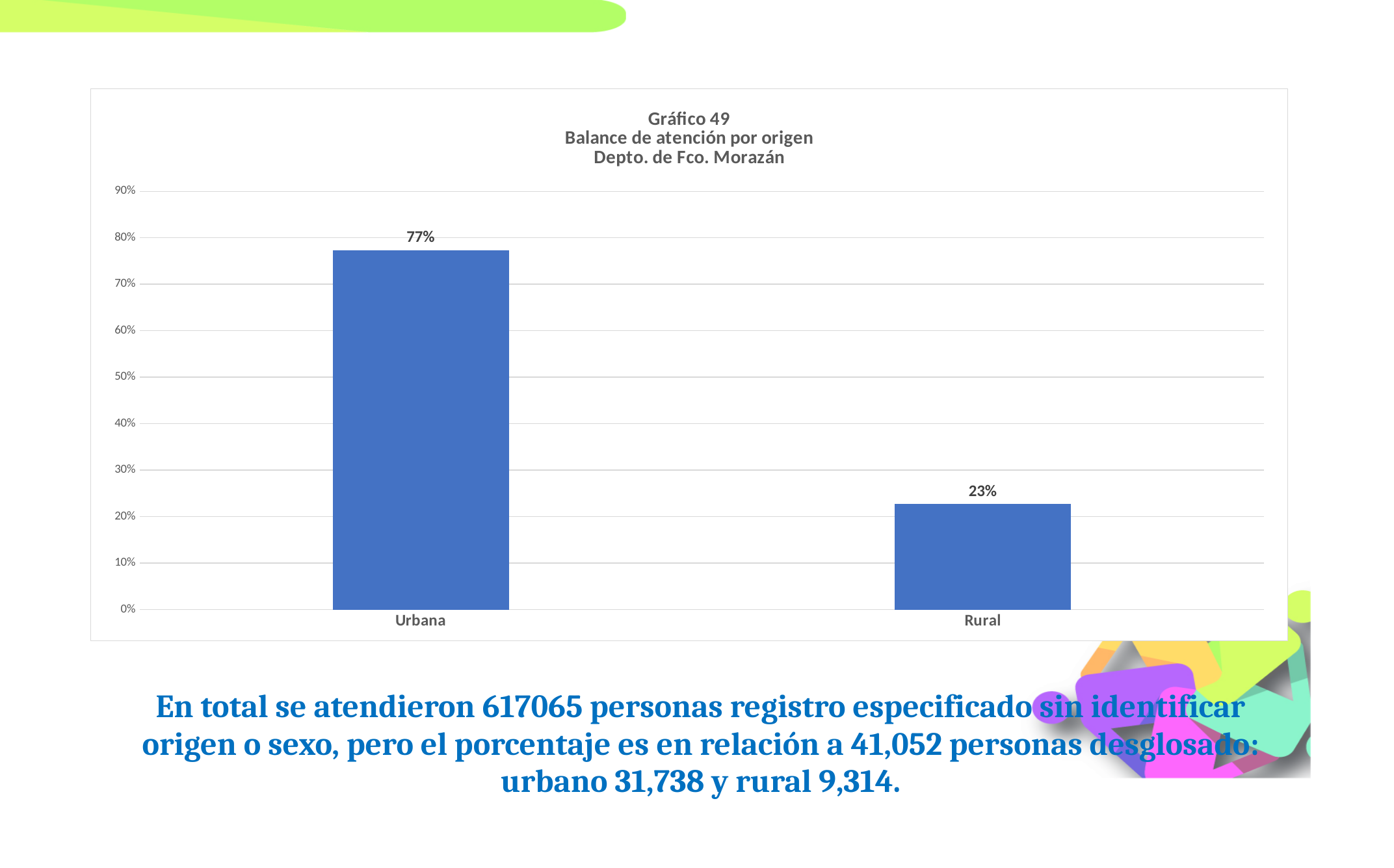
How many categories are shown on the x axis? 2 What is the value for Rural? 23% What is the title of the chart? Gráfico 49 Balance de atención por origen Depto. de Fco. Morazán What is the value for Urbana? 77% Which is larger, the value for Urbana or the value for Rural? Urbana Is the value for Urbana greater or less than 70%? greater Is the value for Rural greater or less than 30%? less Which category has the highest value? Urbana What is the highest value shown on the y axis? 90% What kind of chart is shown on the slide? bar chart Which category has the lowest value? Rural What is the difference between the values for Urbana and Rural? 54%